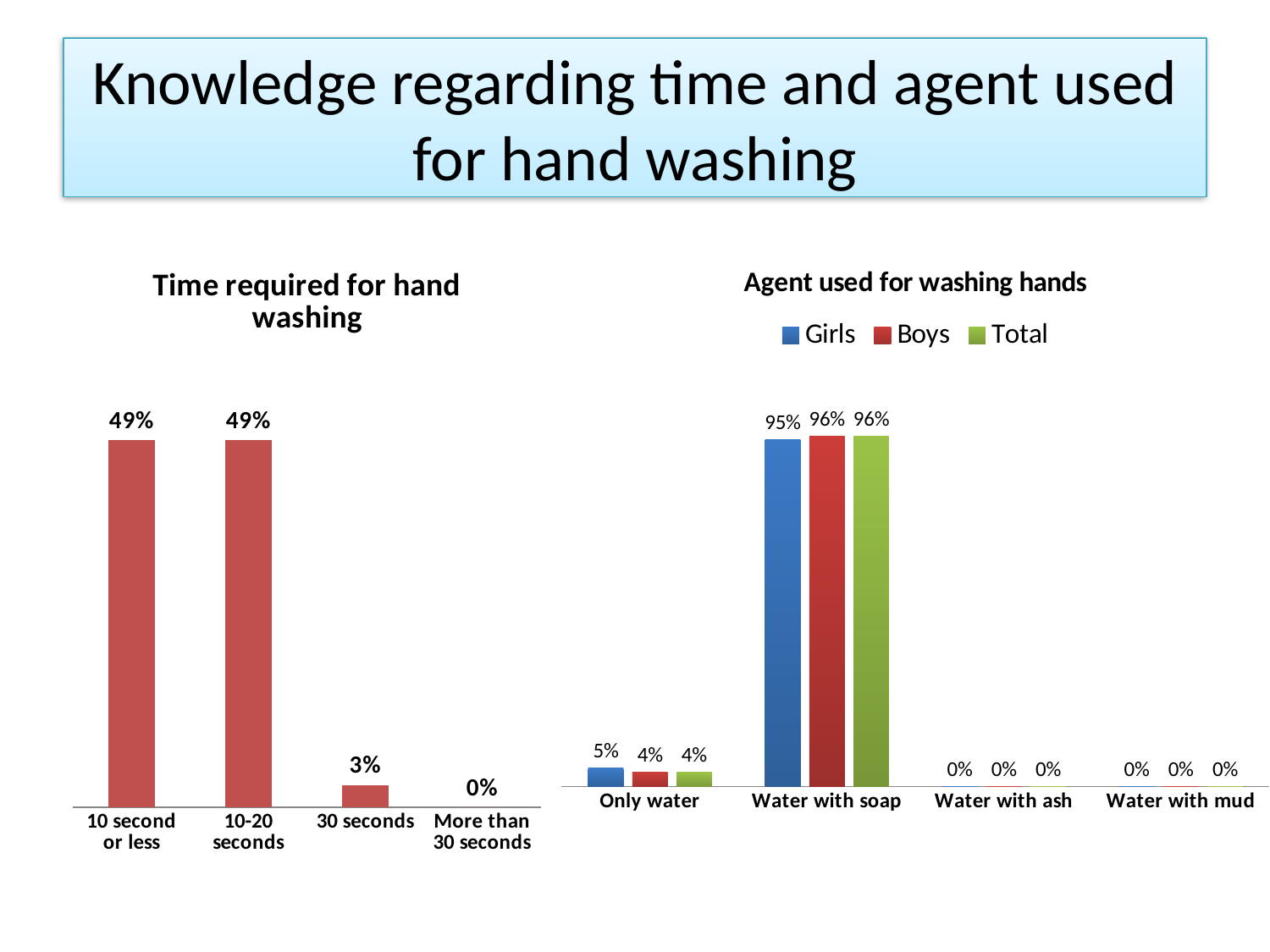
In the 'Time required for hand washing' chart, how many categories are shown on the x axis? 4 In the 'Time required for hand washing' chart, which category has the lowest value? More than 30 seconds In the 'Time required for hand washing' chart, what is the value for 'More than 30 seconds'? 0% In the 'Agent used for washing hands' chart, what is the difference between the Boys values for 'Water with soap' and 'Only water'? 92% In the 'Agent used for washing hands' chart, how many series does the legend list? 3 In the 'Agent used for washing hands' chart, which category has the highest Total value? Water with soap What kind of chart is the 'Agent used for washing hands' chart? Bar chart In the 'Agent used for washing hands' chart, which is larger: the Girls value for 'Only water' or the Boys value for 'Only water'? Girls In the 'Agent used for washing hands' chart, what is the Girls value for 'Only water'? 5% In the 'Time required for hand washing' chart, what is the difference between the values for '10-20 seconds' and '30 seconds'? 46% In the 'Agent used for washing hands' chart, what is the Girls value for 'Water with soap'? 95% In the 'Time required for hand washing' chart, what is the value for '30 seconds'? 3%